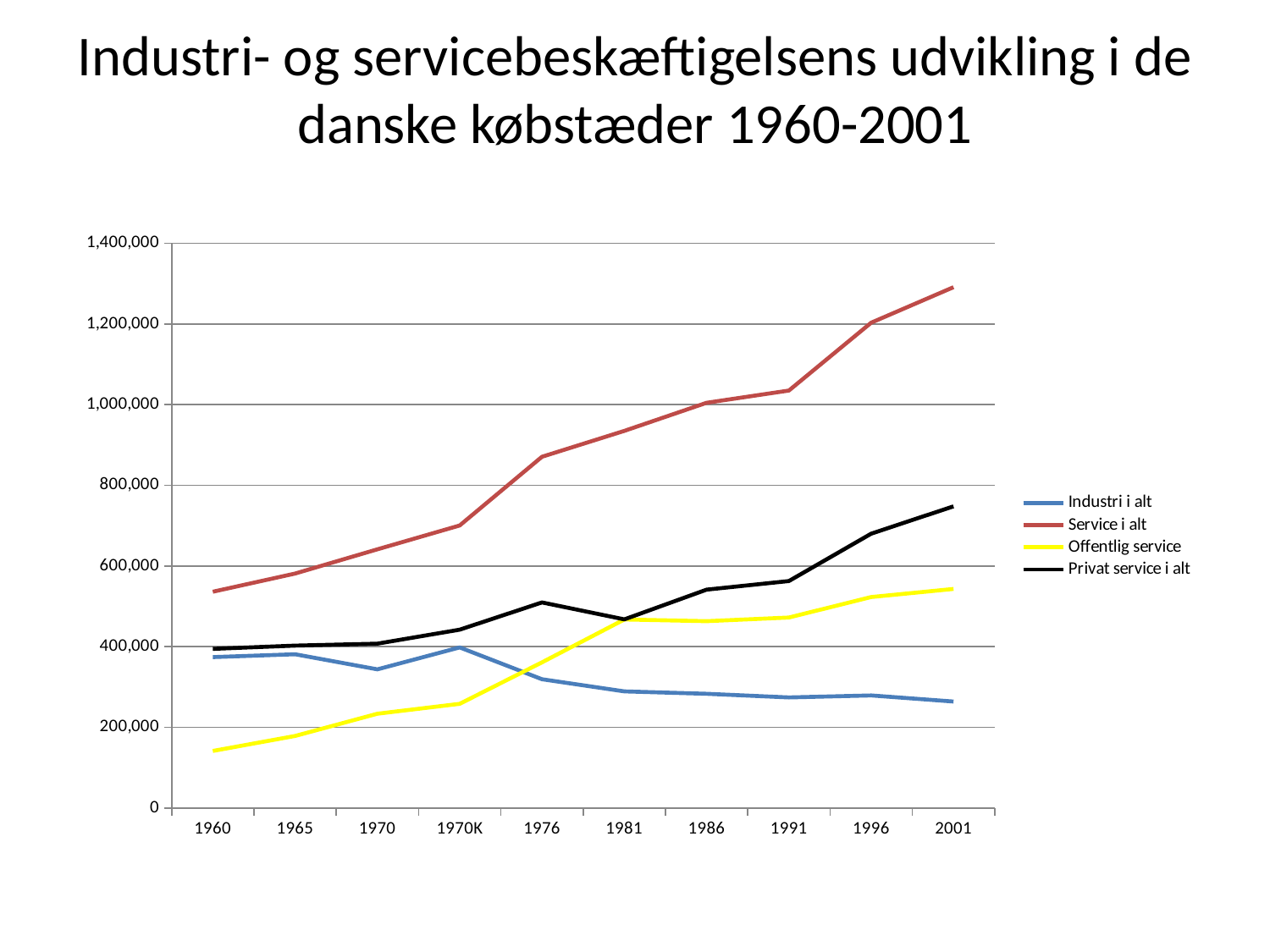
How many series does the legend list? 4 What kind of chart is shown on the slide? line chart Does the value for Service i alt rise or fall from 1960 to 2001? rise Is the value for Offentlig service in 1960 greater or less than 200,000? less Is the value for Service i alt in 2001 greater or less than 1,200,000? greater In 2001, which is larger: Privat service i alt or Offentlig service? Privat service i alt Is the value for Industri i alt in 2001 greater or less than 400,000? less How many points are there along the x axis? 10 Does the value for Industri i alt rise or fall from 1970K to 2001? fall Which series has the highest value in 2001? Service i alt Which series has the lowest value in 1960? Offentlig service